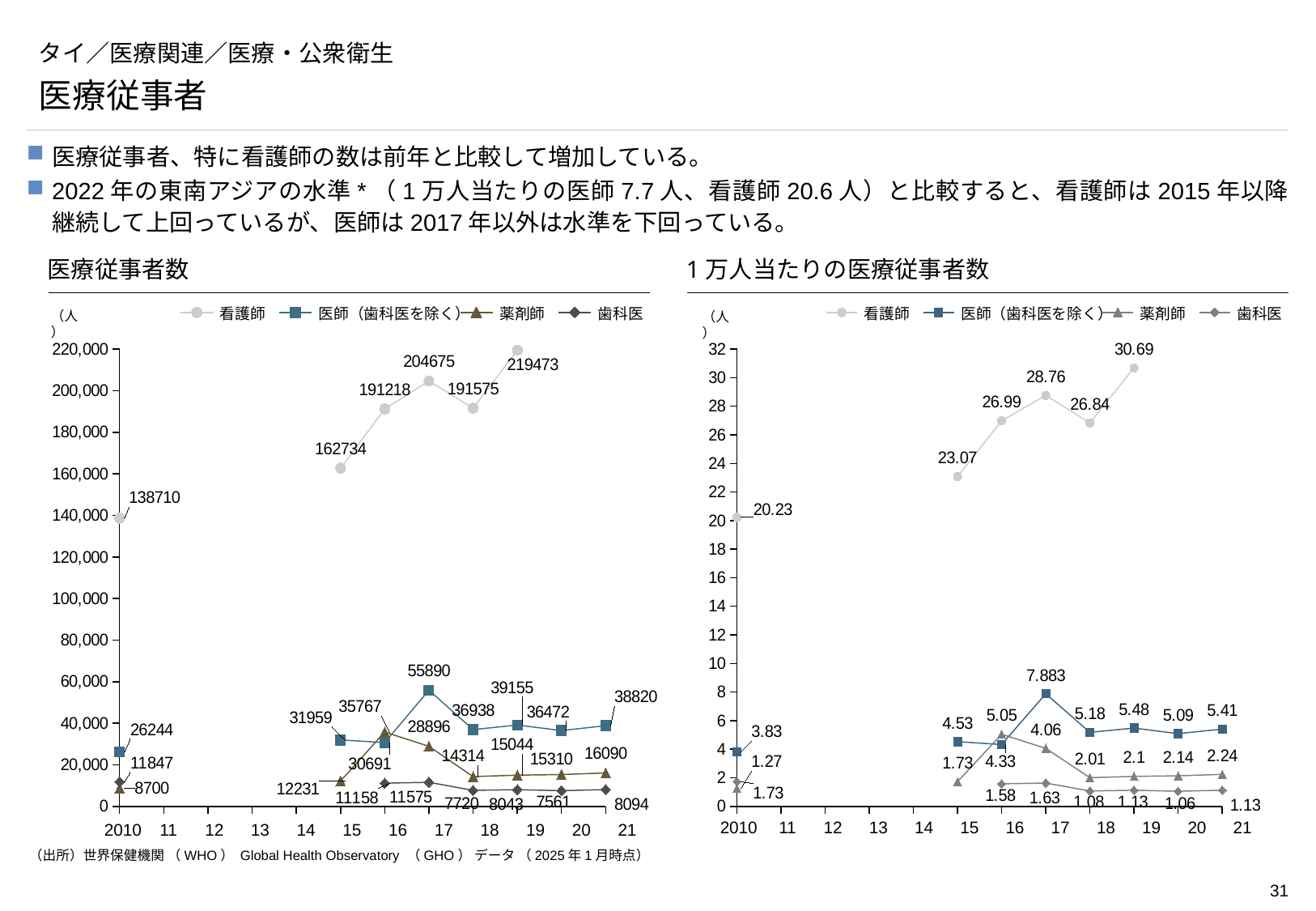
In the right chart (1万人当たりの医療従事者数), what is the highest value shown for 看護師? 30.69 In the right chart (1万人当たりの医療従事者数), what is the value for 医師（歯科医を除く） in 2010? 3.83 In the left chart (医療従事者数), what is the value for 医師（歯科医を除く） in 2010? 26244 How many series does the legend of the left chart (医療従事者数) list? 4 What kind of chart is the left chart titled 医療従事者数? line chart In the right chart (1万人当たりの医療従事者数), which series has the highest values overall? 看護師 In the left chart (医療従事者数), what is the difference between the highest 看護師 value and the 2010 看護師 value? 80763 In the left chart (医療従事者数), what is the highest value shown for 看護師? 219473 In the right chart (1万人当たりの医療従事者数), what is the value for 看護師 in 2010? 20.23 In the left chart (医療従事者数), what is the highest value shown for 医師（歯科医を除く）? 55890 In the left chart (医療従事者数), what is the value for 看護師 in 2010? 138710